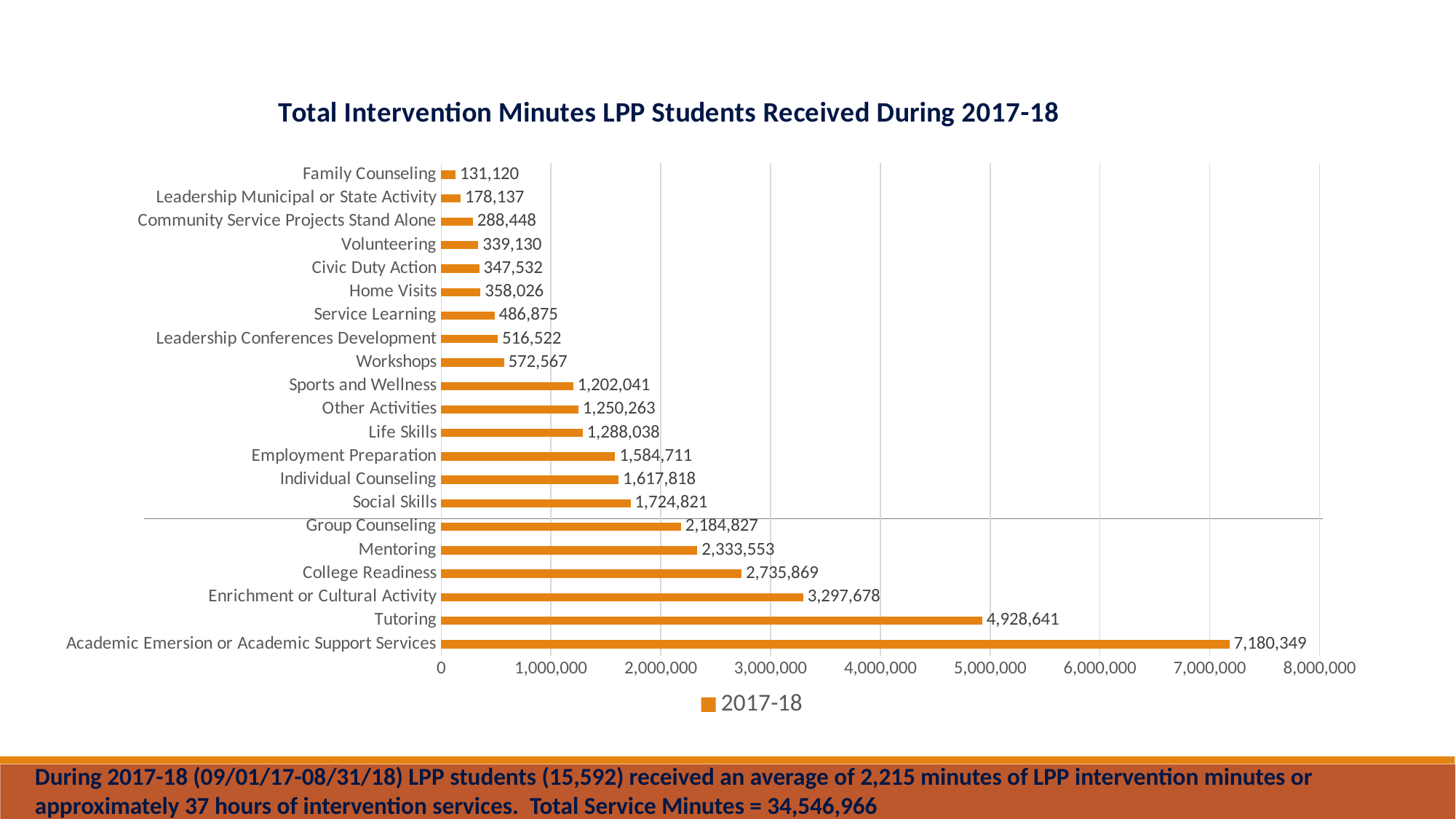
How many categories are shown in the chart? 21 Is the value for Enrichment or Cultural Activity greater or less than 3,000,000? greater What is the value for Tutoring? 4,928,641 What is the value for Home Visits? 358,026 Which category has the highest total intervention minutes? Academic Emersion or Academic Support Services What is the difference between Tutoring and Enrichment or Cultural Activity? 1,630,963 What is the difference between Academic Emersion or Academic Support Services and Tutoring? 2,251,708 How many intervention minutes are shown for Mentoring? 2,333,553 What kind of chart is shown on the slide? Bar chart Which category has the lowest total intervention minutes? Family Counseling Which is larger, College Readiness or Group Counseling? College Readiness What series does the legend list? 2017-18